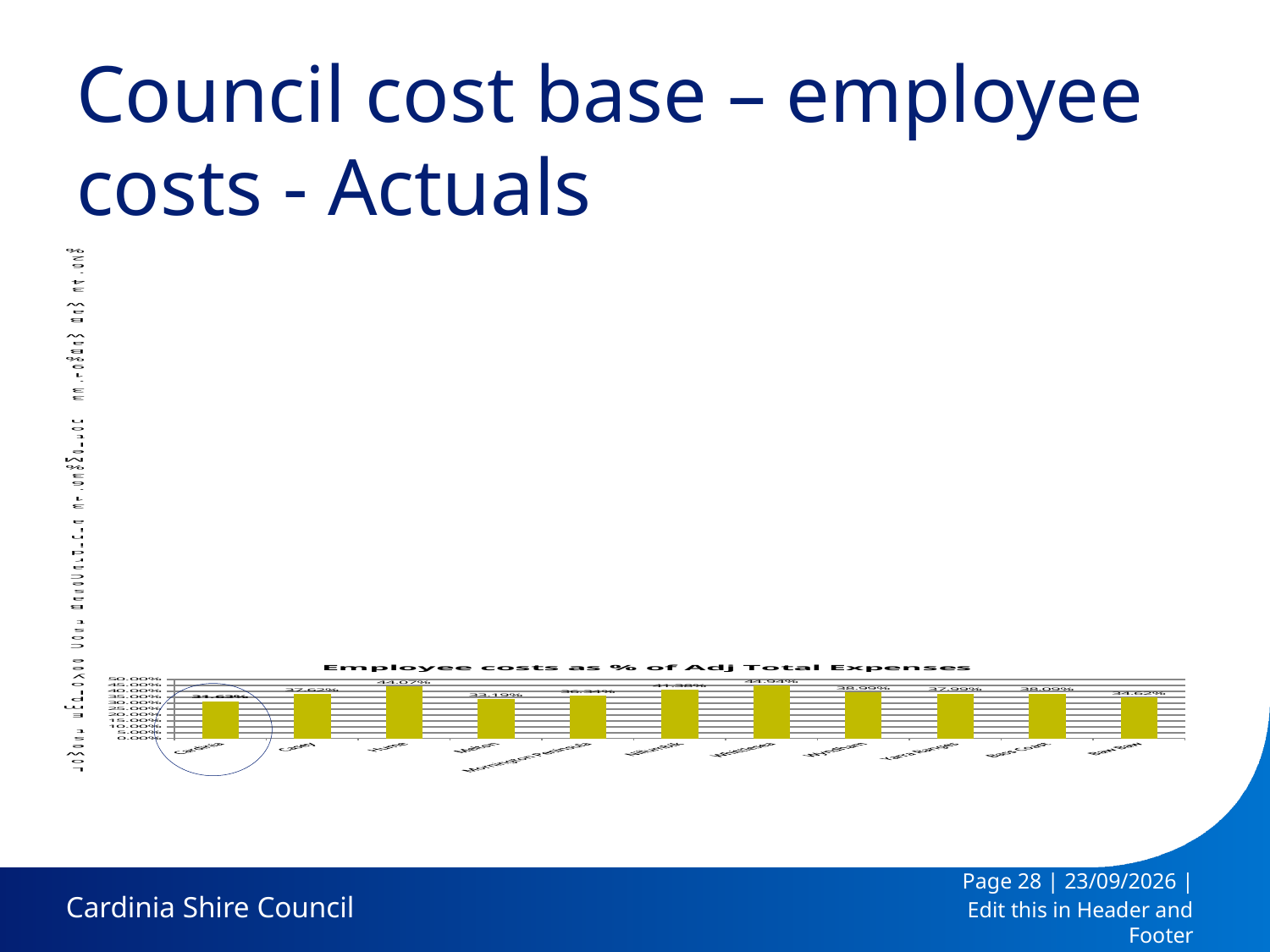
What is the difference between the values for Whittlesea and Cardinia? 13.31% Which council has the lowest employee costs as % of adjusted total expenses? Cardinia What is the value for Melton? 33.19% What kind of chart is shown on the slide? bar chart How many councils are plotted in the chart? 11 Which is larger, the value for Casey or the value for Melton? Casey What is the title of the chart? Employee costs as % of Adj Total Expenses Which council has the highest employee costs as % of adjusted total expenses? Whittlesea What is the value for Cardinia? 31.63% What is the value for Whittlesea? 44.94% Is the value for Nillumbik greater or less than 40.00%? greater What is the value for Hume? 44.07%